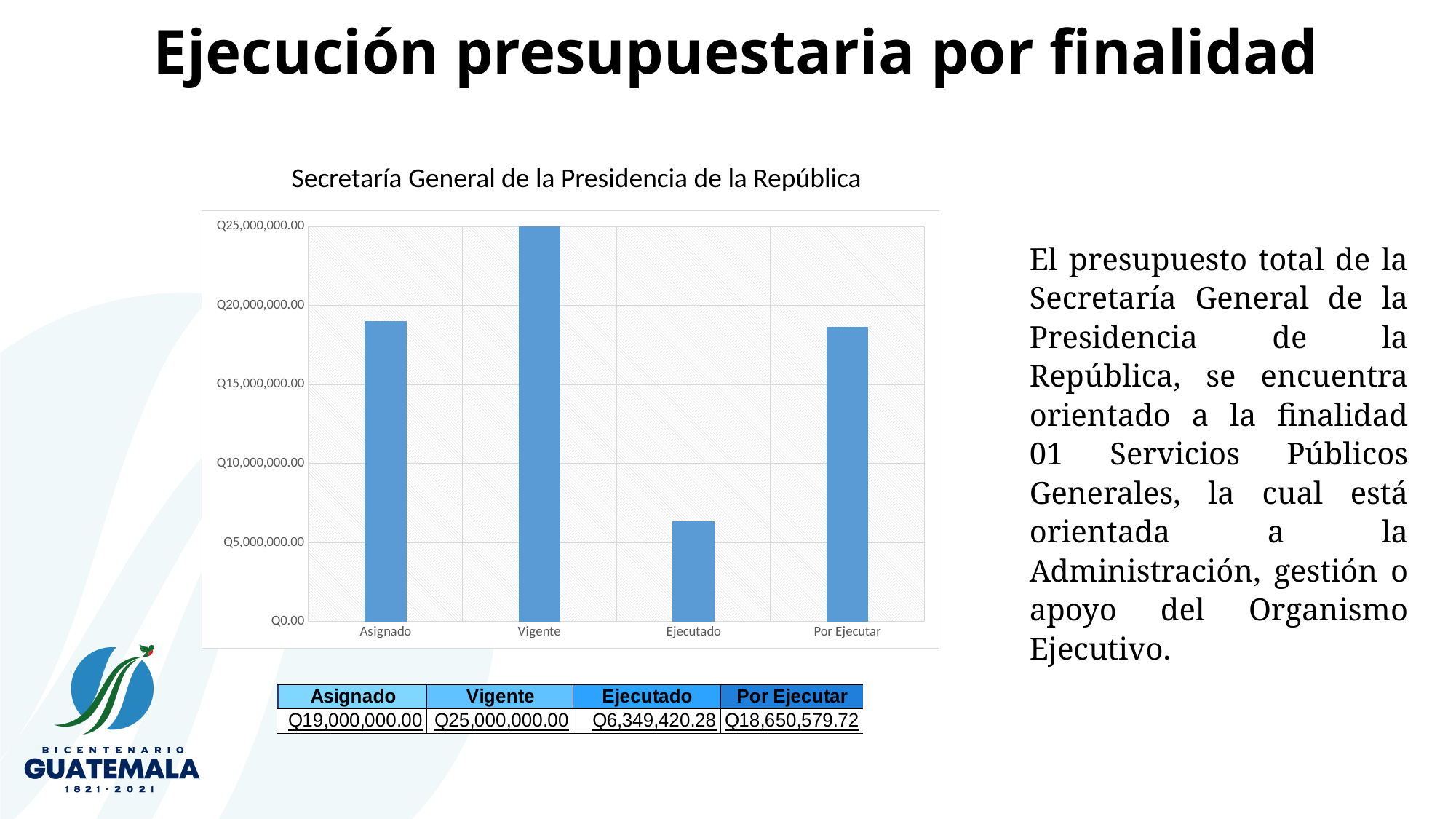
What is the value for Por Ejecutar in the chart? Q18,650,579.72 What is the value for Ejecutado in the chart? Q6,349,420.28 What is the value for Asignado in the chart? Q19,000,000.00 What is the title of the chart? Secretaría General de la Presidencia de la República Is the value for Ejecutado greater or less than Q10,000,000.00? less What kind of chart is shown on the slide? bar chart Which is larger, the value for Asignado or the value for Por Ejecutar? Asignado How many categories are shown on the x axis of the chart? 4 Which category has the lowest value in the chart? Ejecutado What is the value for Vigente in the chart? Q25,000,000.00 What is the difference between the Vigente and Ejecutado values? Q18,650,579.72 Which category has the highest value in the chart? Vigente